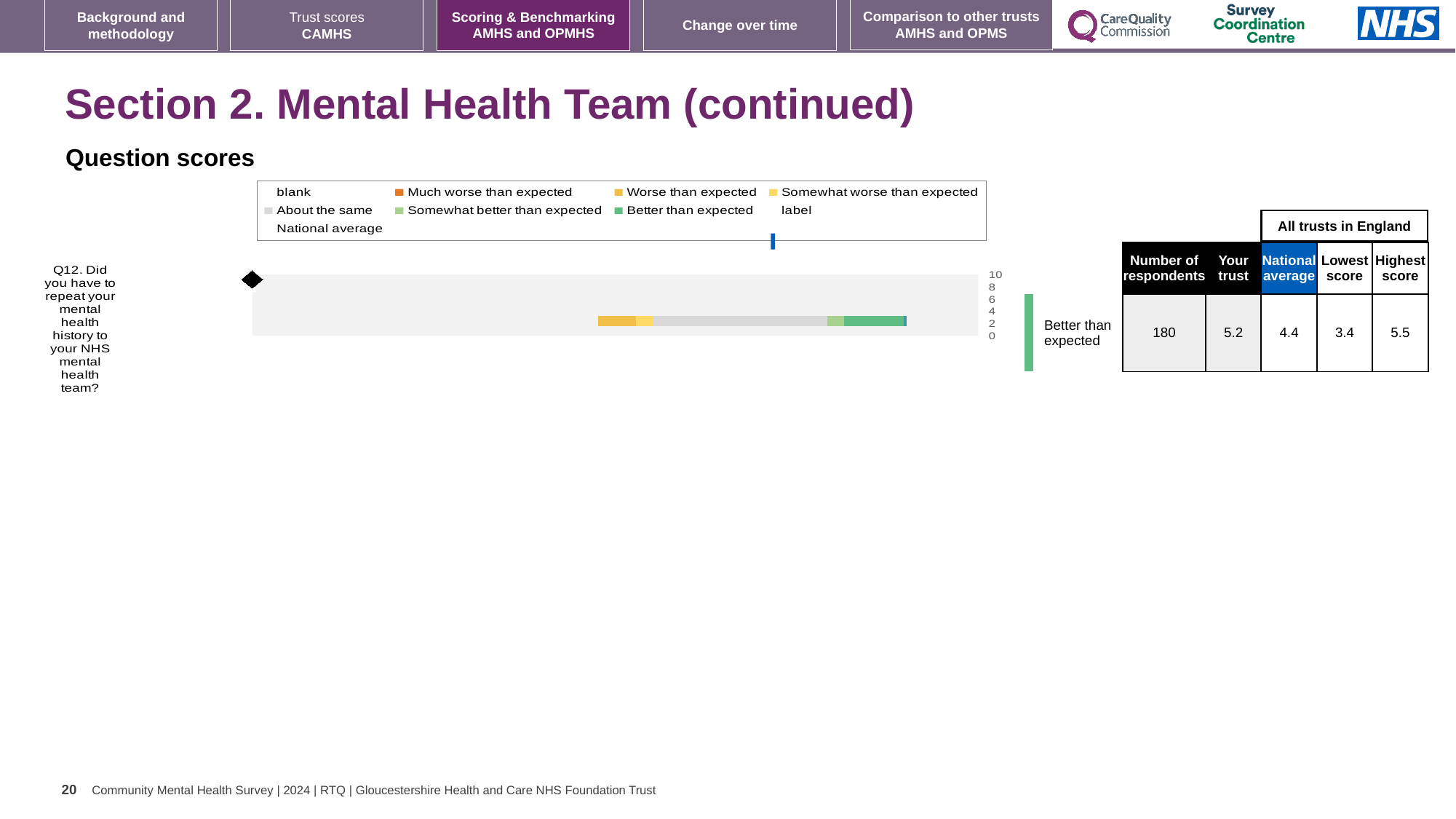
What is the lowest score among all trusts in England for Q12? 3.4 For Q12, what is the difference between the highest score and the lowest score among all trusts in England? 2.1 How many respondents answered Q12? 180 What is the national average score for Q12? 4.4 How many survey questions are plotted in the Question scores chart? 1 What benchmark rating label is shown to the right of the Q12 bar? Better than expected What kind of chart is shown under 'Question scores'? bar chart For Q12, which is higher: the 'Your trust' score or the national average? Your trust What is the 'Your trust' score for Q12? 5.2 For Q12, what is the difference between the 'Your trust' score and the national average? 0.8 What is the highest score among all trusts in England for Q12? 5.5 Which survey question is plotted in the Question scores chart? Q12. Did you have to repeat your mental health history to your NHS mental health team?